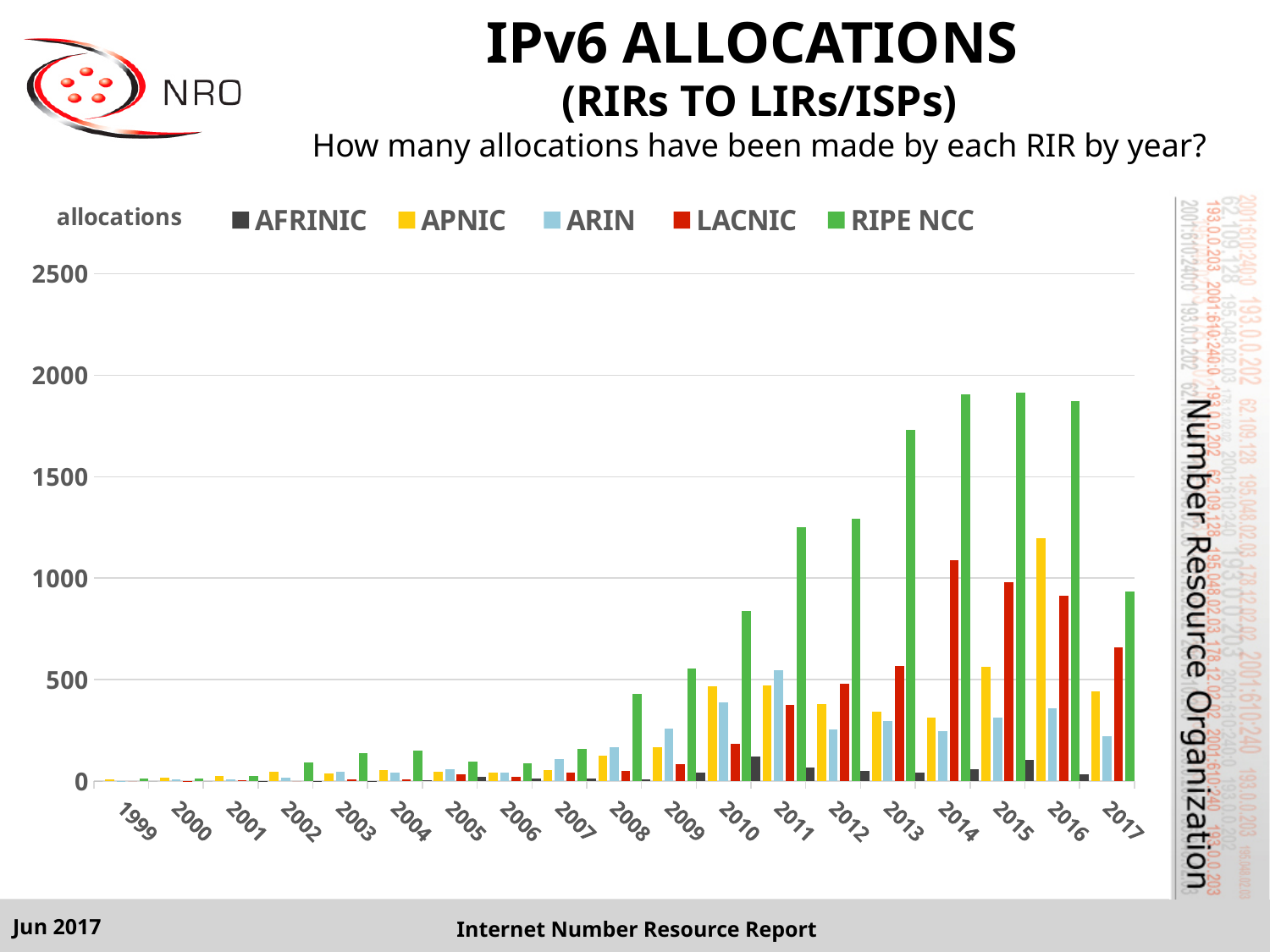
Is the value for ARIN in 2011 greater or less than 1000? less In 2016, which is larger: the APNIC value or the LACNIC value? APNIC Do the RIPE NCC values rise or fall from 2009 to 2015? rise Is the value for APNIC in 2016 greater or less than 1000? greater In 2013, which is larger: the LACNIC value or the APNIC value? LACNIC Is the value for RIPE NCC in 2014 greater or less than 1500? greater How many years are shown along the x axis? 19 What kind of chart is shown on the slide? bar chart How many series does the legend list? 5 Which RIR has the lowest number of allocations in 2016? AFRINIC Which RIR has the highest number of allocations in 2015? RIPE NCC